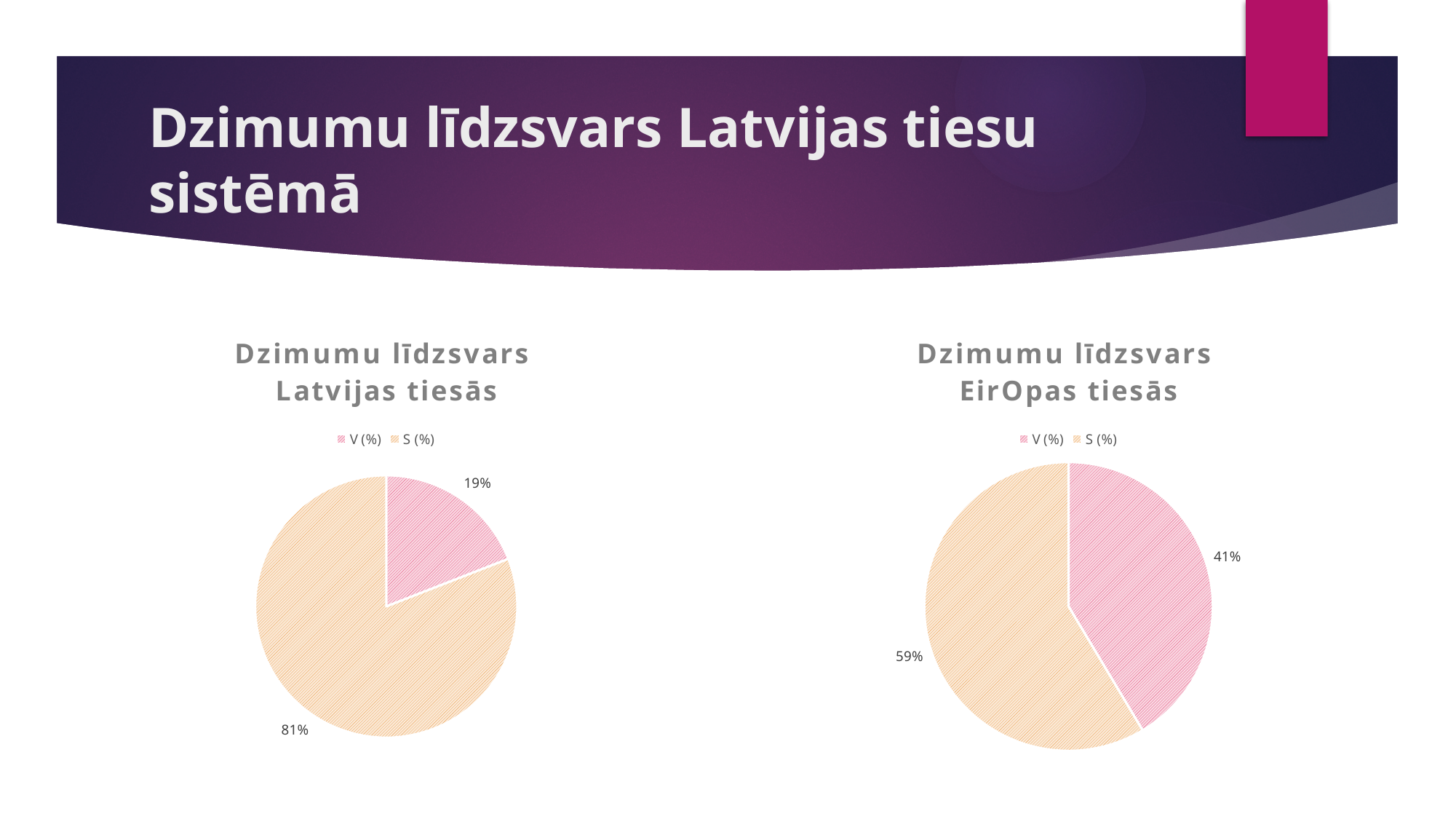
What type of chart is the chart titled "Dzimumu līdzsvars Latvijas tiesās"? Pie chart In the chart titled "Dzimumu līdzsvars EirOpas tiesās", what is the value for S (%)? 59% In the chart titled "Dzimumu līdzsvars Latvijas tiesās", what is the difference between the S (%) and V (%) values? 62% In the chart titled "Dzimumu līdzsvars EirOpas tiesās", what is the difference between the S (%) and V (%) values? 18% How many entries does the legend of the chart titled "Dzimumu līdzsvars Latvijas tiesās" list? 2 In the chart titled "Dzimumu līdzsvars Latvijas tiesās", which category has the largest slice? S (%) How many slices does the chart titled "Dzimumu līdzsvars EirOpas tiesās" have? 2 In the chart titled "Dzimumu līdzsvars EirOpas tiesās", what is the value for V (%)? 41% In the chart titled "Dzimumu līdzsvars Latvijas tiesās", what is the value for V (%)? 19% In the chart titled "Dzimumu līdzsvars Latvijas tiesās", what is the value for S (%)? 81% Is the V (%) value larger in the chart titled "Dzimumu līdzsvars Latvijas tiesās" or in the chart titled "Dzimumu līdzsvars EirOpas tiesās"? Dzimumu līdzsvars EirOpas tiesās In the chart titled "Dzimumu līdzsvars EirOpas tiesās", which category has the smallest slice? V (%)